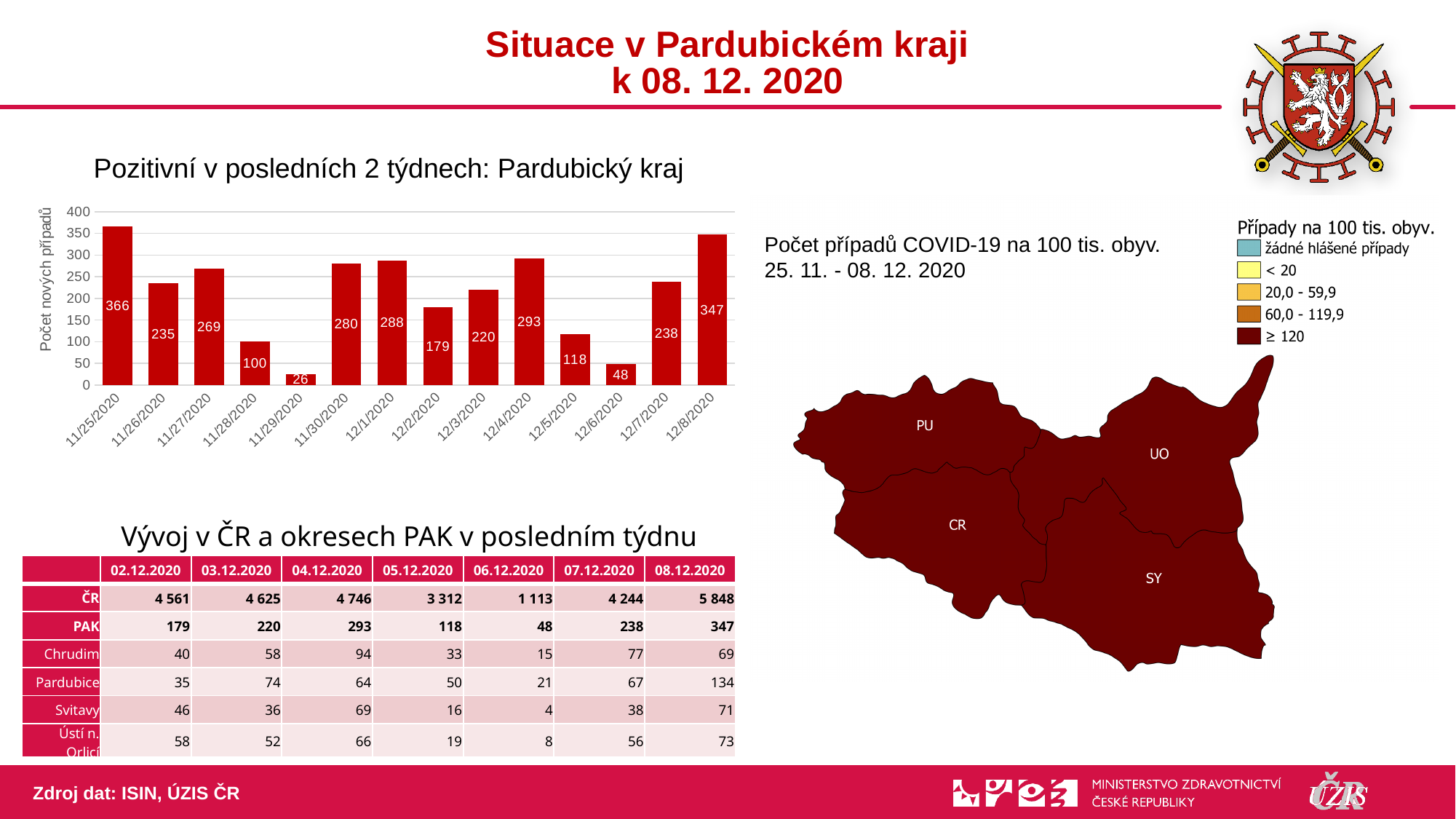
In the bar chart, is the value for 12/5/2020 greater or less than 100? greater In the bar chart, what is the value for 12/8/2020? 347 In the bar chart, what is the difference between the values for 11/25/2020 and 12/8/2020? 19 In the bar chart, what is the value for 11/29/2020? 26 How many dates (bars) are shown in the bar chart? 14 In the bar chart, what is the value for 12/2/2020? 179 In the bar chart, which is larger: the value for 12/4/2020 or the value for 12/1/2020? 12/4/2020 What type of chart is shown under the title 'Pozitivní v posledních 2 týdnech: Pardubický kraj'? bar chart In the bar chart, what is the value for 11/25/2020? 366 Which date has the highest bar in the bar chart? 11/25/2020 What is the label on the vertical axis of the bar chart? Počet nových případů Which date has the lowest bar in the bar chart? 11/29/2020